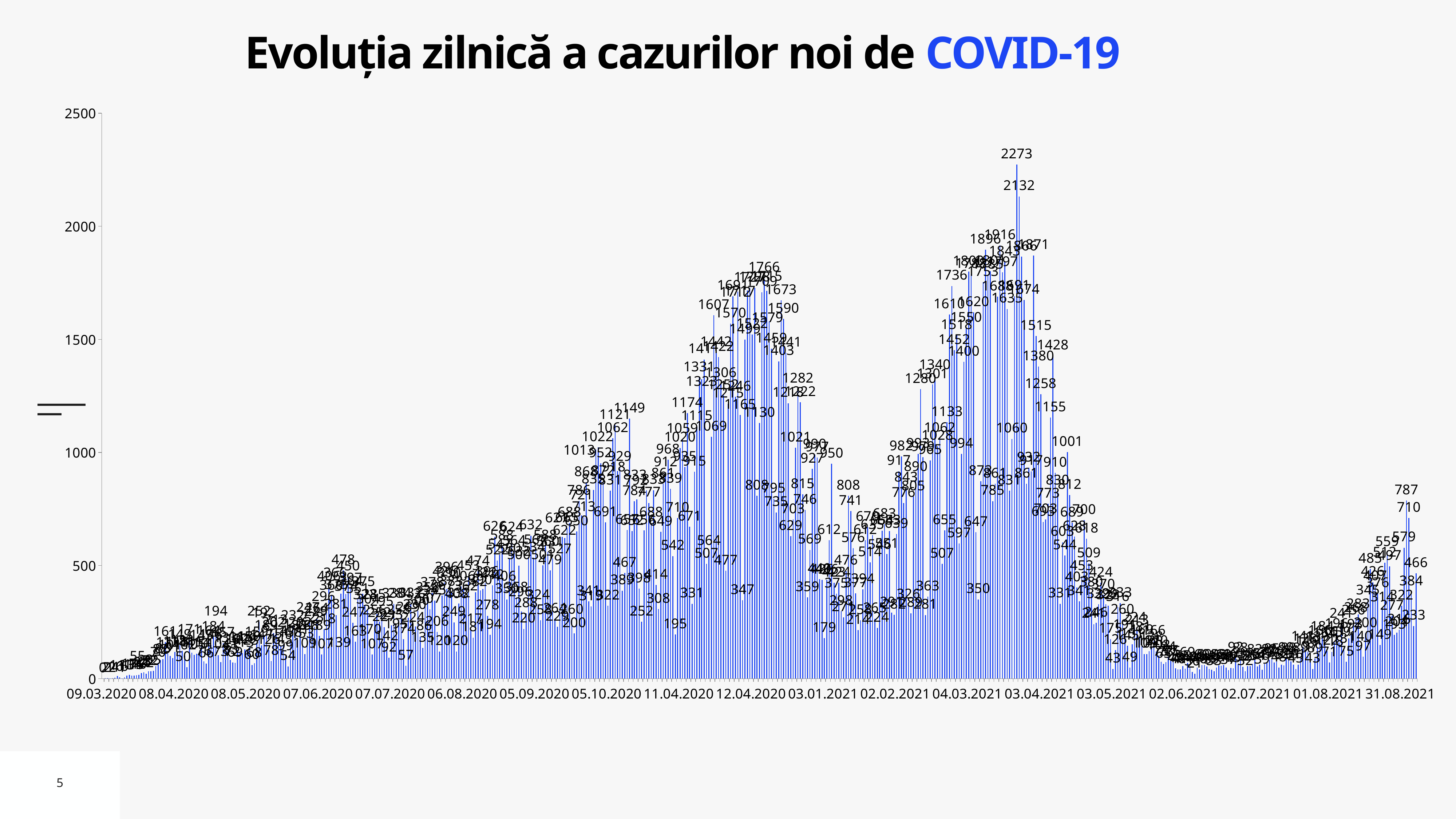
Do the values rise or fall along the x axis between 03.05.2021 and 02.06.2021? fall What is the maximum value shown on the y axis? 2500 What kind of chart is shown on the slide? bar chart Is the value of the last bar on the right (around 31.08.2021) greater or less than 500? less Is the highest bar on the chart greater or less than 2000? greater What is the difference between the two highest labelled values, 2273 and 2132? 141 What is the second-highest data label shown on the chart, next to the 2273 peak? 2132 What is the highest daily value shown on the chart? 2273 Which is larger, the bar labelled 2273 or the bar labelled 2132? 2273 What is the title of the chart? Evoluția zilnică a cazurilor noi de COVID-19 How many date labels are shown on the x axis? 19 Do the values rise or fall along the x axis between 01.08.2021 and 31.08.2021? rise